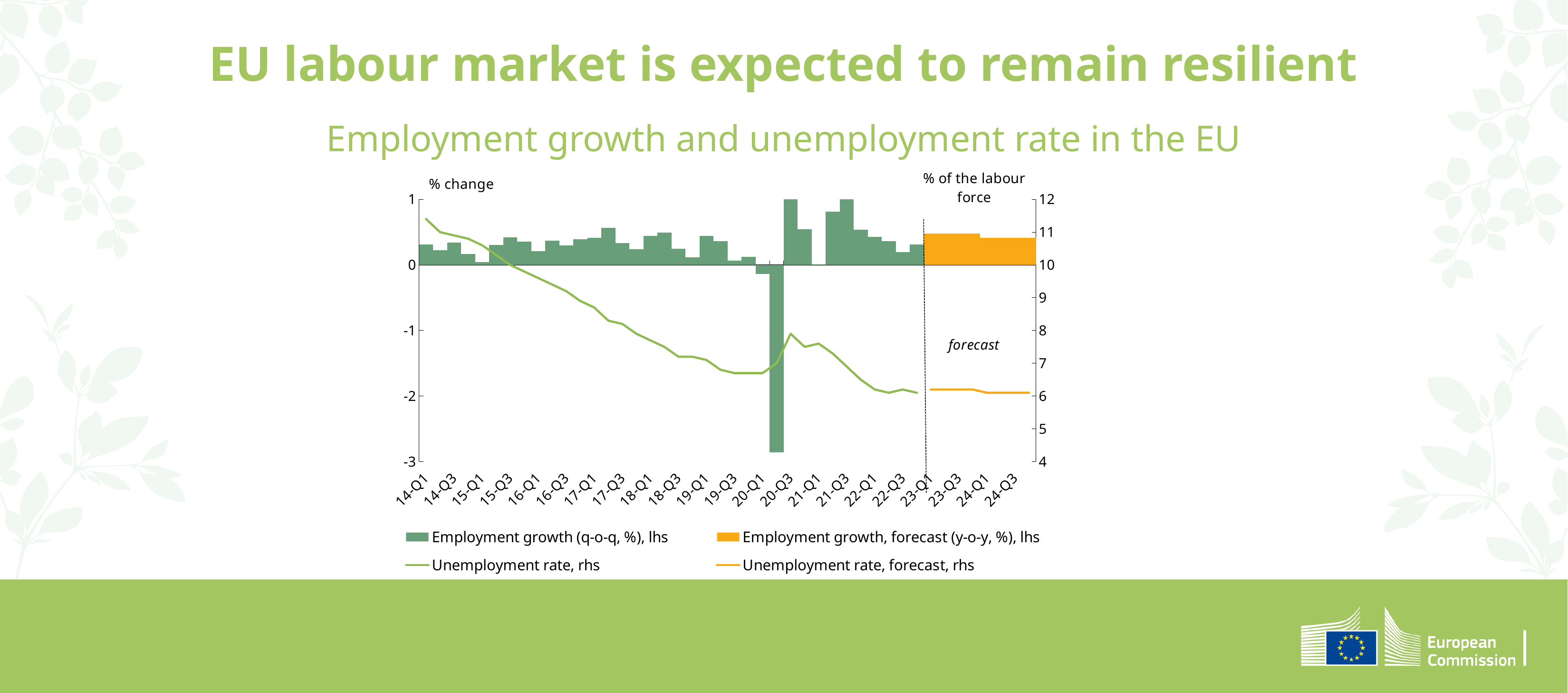
What is the label of the right-hand axis? % of the labour force Is the forecast employment growth bar at 23-Q3 greater or less than 0? greater What kind of chart is shown on the slide? A combined bar and line chart Is the unemployment rate at 22-Q3 greater or less than 7? less Does the unemployment rate rise or fall between 14-Q1 and 19-Q3? fall Which is higher, the unemployment rate at 14-Q1 or at 22-Q3? 14-Q1 Is the forecast unemployment rate at 24-Q3 greater or less than 7? less In which year does the lowest employment growth bar occur? 2020 How many quarter labels are shown on the x axis? 22 What is the title of the chart? Employment growth and unemployment rate in the EU How many series does the legend list? 4